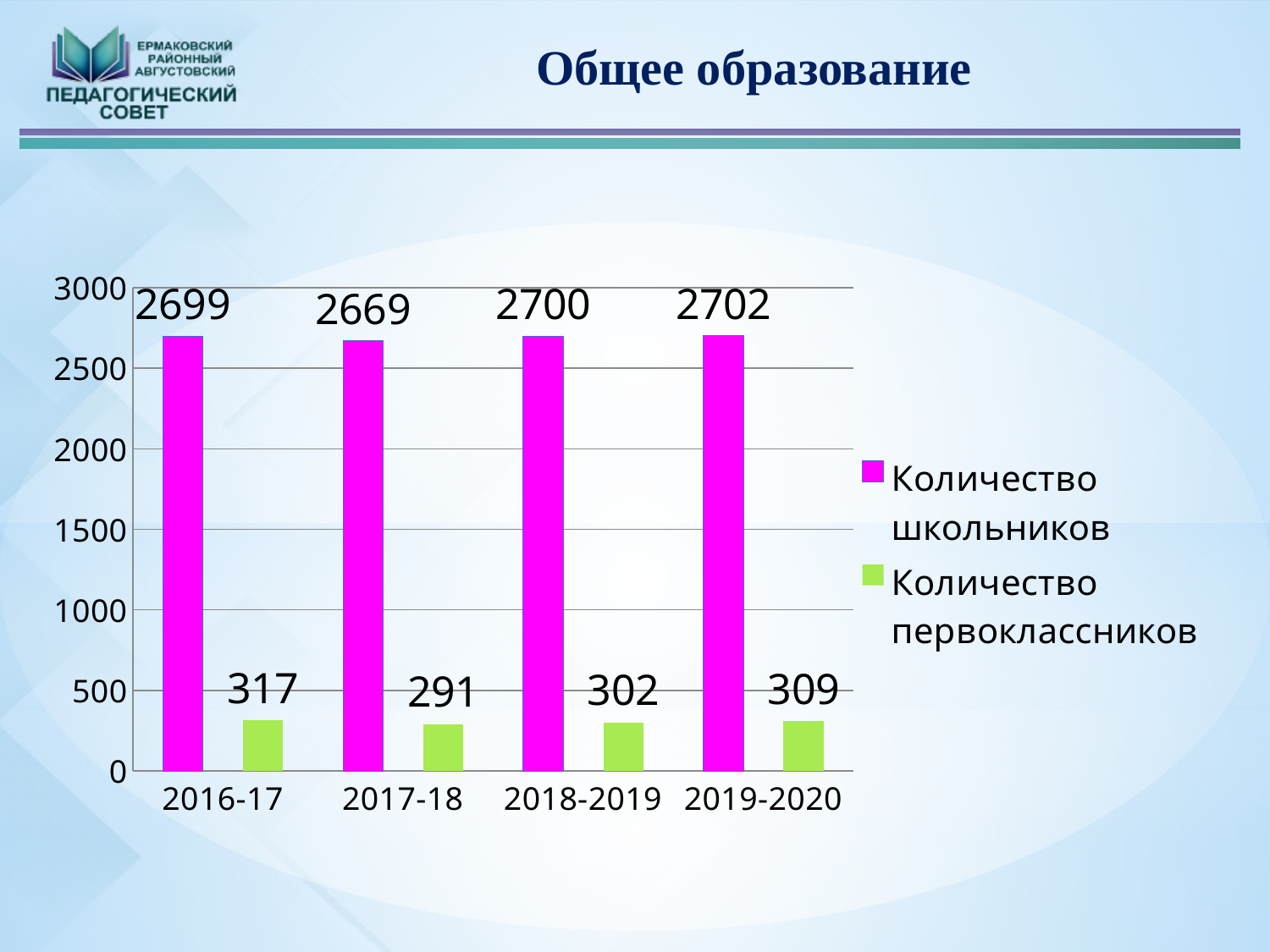
Which year has the highest value for Количество первоклассников? 2016-17 What is the value for Количество школьников in 2019-2020? 2702 Is the value for Количество первоклассников in 2016-17 greater or less than 500? less What is the difference between Количество первоклассников in 2016-17 and 2017-18? 26 How many years are shown on the x axis? 4 Which year has the lowest value for Количество школьников? 2017-18 How many series does the legend list? 2 What is the difference between Количество школьников in 2019-2020 and 2017-18? 33 Which is larger: Количество первоклассников in 2018-2019 or in 2019-2020? 2019-2020 What is the value for Количество школьников in 2016-17? 2699 What kind of chart is shown on the slide? bar chart What is the value for Количество первоклассников in 2017-18? 291